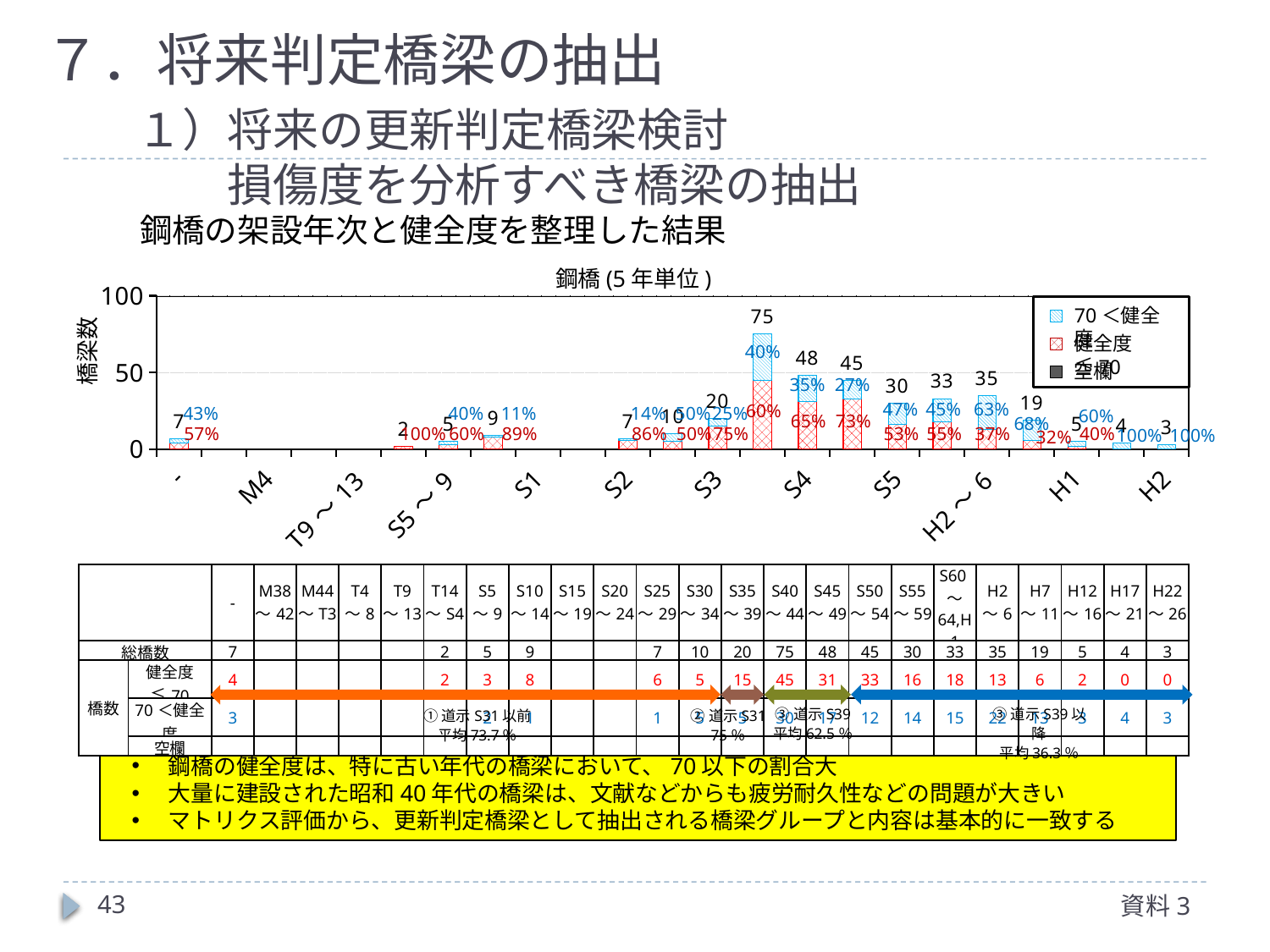
How many series does the chart legend list? 3 What is the total number of bridges shown for the S45～49 period? 48 What percentage of the S40～44 bar is labelled for the 70＜健全度 series? 40% What kind of chart is shown on the slide? bar chart Which period has more bridges, S50～54 or S55～59? S50～54 What is the difference between the number of bridges in S40～44 and S45～49? 27 What is the total number of bridges shown for the H22～26 period? 3 Is the number of bridges for S40～44 greater or less than 50? greater What is the total number of bridges shown for the S40～44 period? 75 What is the label on the vertical axis of the chart? 橋梁数 Which construction period has the highest number of bridges in the chart? S40～44 What is the title of the chart? 鋼橋(5年単位)